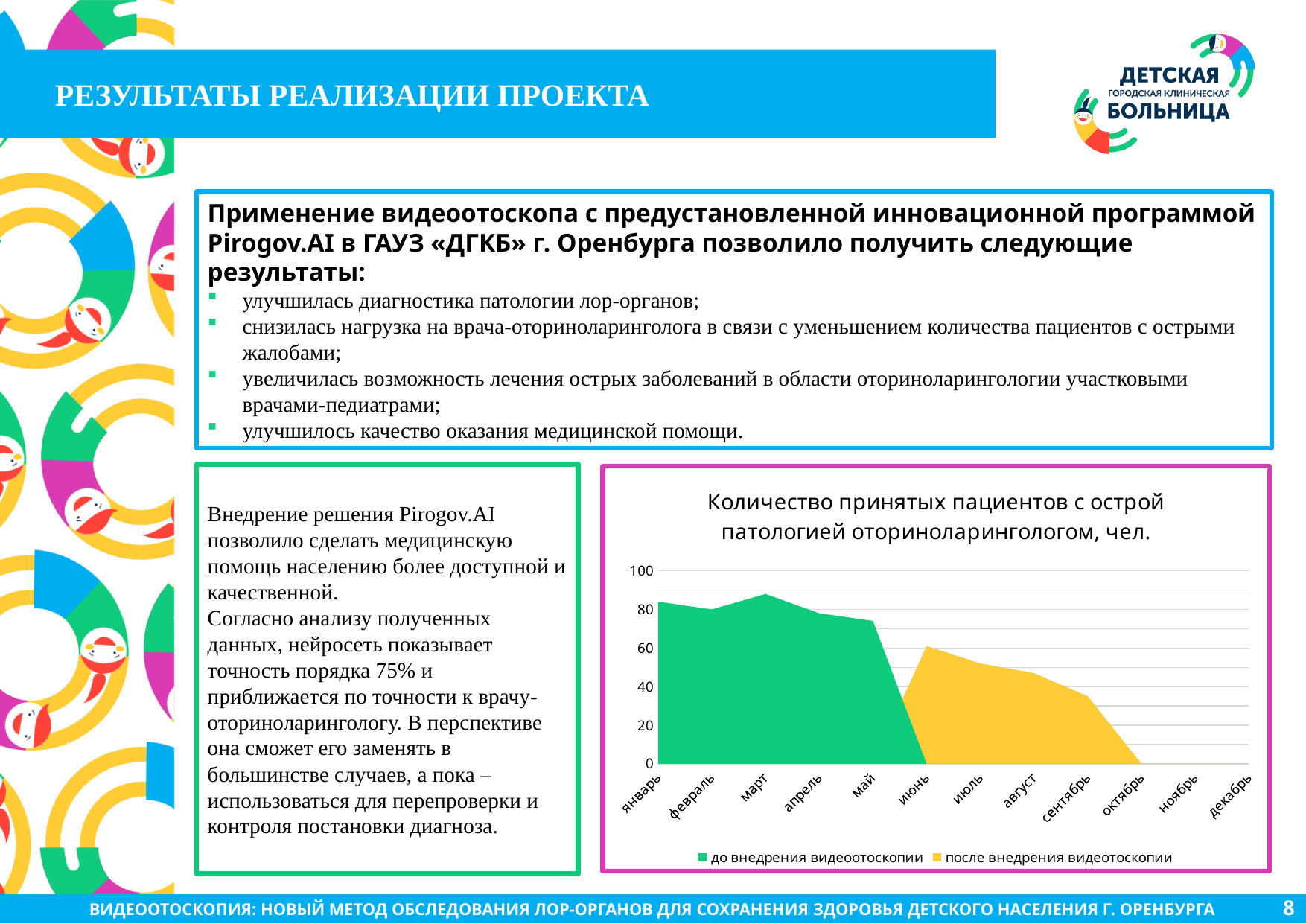
Do the values of the series 'после внедрения видеоотоскопии' rise or fall from июнь to сентябрь? fall How many series does the chart legend list? 2 Is the value for сентябрь in the series 'после внедрения видеоотоскопии' greater or less than 40? less What is the title of the chart? Количество принятых пациентов с острой патологией оториноларингологом, чел. Which is larger: the value for апрель in 'до внедрения видеоотоскопии' or the value for июль in 'после внедрения видеоотоскопии'? апрель in 'до внедрения видеоотоскопии' Is the value for май in the series 'до внедрения видеоотоскопии' greater or less than 60? greater Which colour represents the series 'после внедрения видеоотоскопии' in the chart? yellow Which is larger in the series 'до внедрения видеоотоскопии': the value for январь or the value for май? январь How many months are shown on the x axis of the chart? 12 Is the value for июнь in the series 'после внедрения видеоотоскопии' greater or less than 40? greater What kind of chart is shown on the slide? area chart